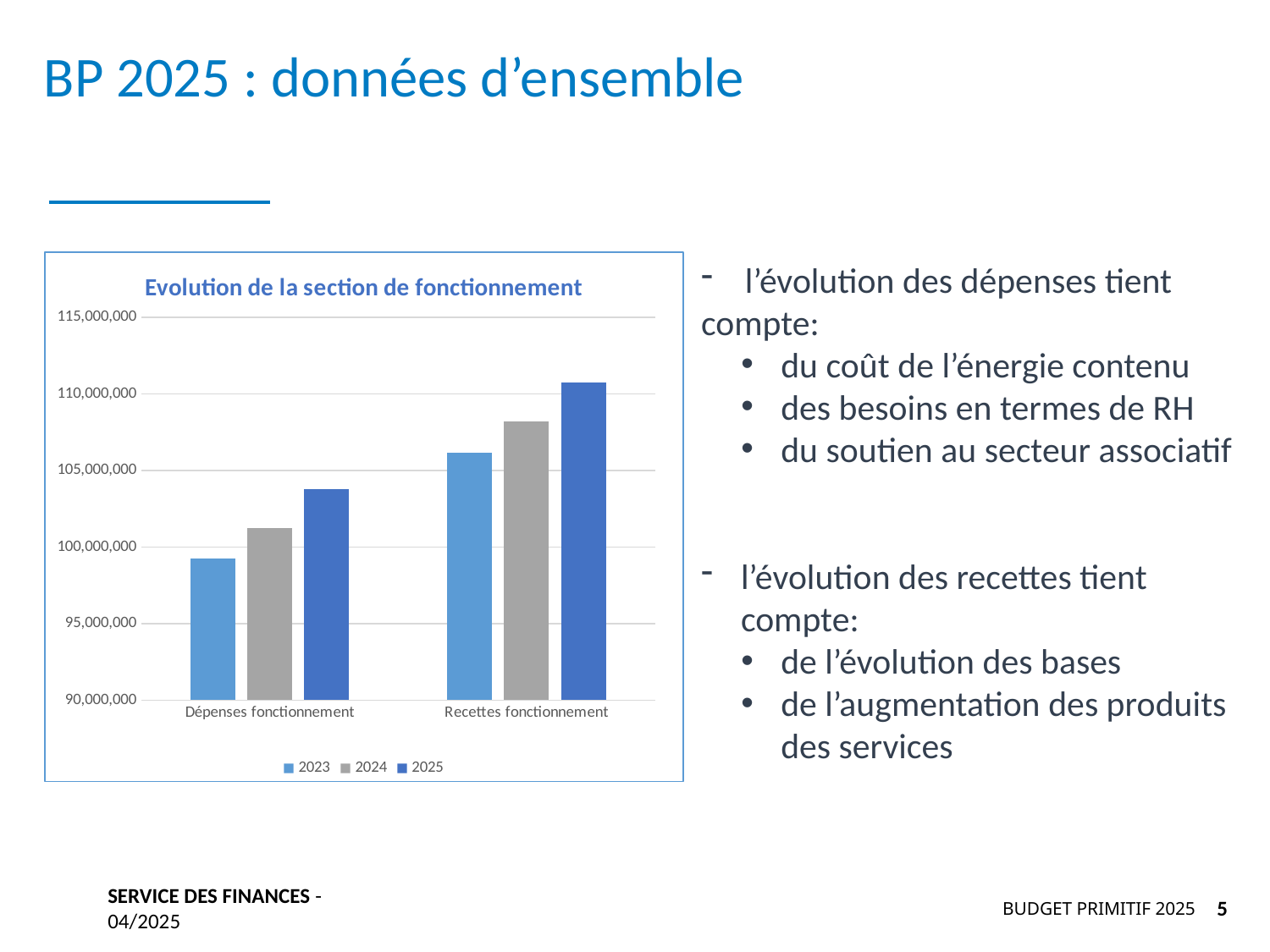
Which series has the lowest value for Dépenses fonctionnement? 2023 How many categories are shown on the x axis of the chart? 2 For 2025, which is larger: Dépenses fonctionnement or Recettes fonctionnement? Recettes fonctionnement Is the value for Recettes fonctionnement in 2023 greater or less than 105,000,000? greater Is the value for Recettes fonctionnement in 2024 greater or less than 110,000,000? less What kind of chart is shown on the slide? bar chart Do the values for Dépenses fonctionnement rise or fall from 2023 to 2025? rise What is the title of the chart? Evolution de la section de fonctionnement Is the value for Dépenses fonctionnement in 2025 greater or less than 105,000,000? less How many series does the chart legend list? 3 Which series has the highest value for Recettes fonctionnement? 2025